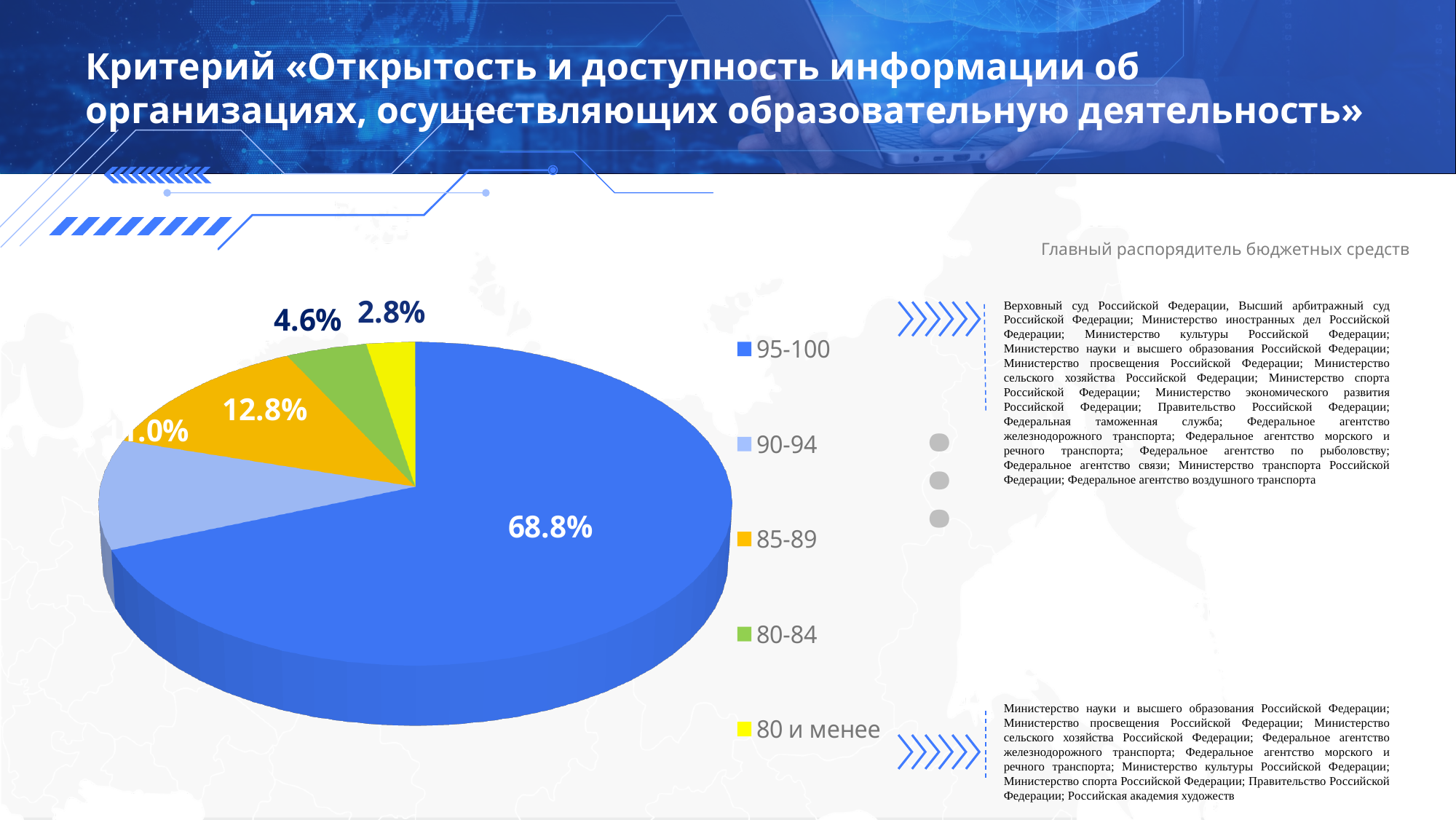
What is the value shown for the '80 и менее' category? 2.8% What is the value shown for the 80-84 category? 4.6% How many categories does the pie chart show? 5 What is the value shown for the 85-89 category? 12.8% Which category has the smallest slice of the pie? 80 и менее What type of chart is shown on the slide? Pie chart What is the difference in percentage points between the 95-100 and 85-89 slices? 56.0 What share of the pie does the 95-100 category hold? 68.8% What is the difference in percentage points between the 85-89 and 80-84 slices? 8.2 Which slice is larger, 80-84 or '80 и менее'? 80-84 Which category has the largest slice of the pie? 95-100 Which slice is larger, 85-89 or 80-84? 85-89